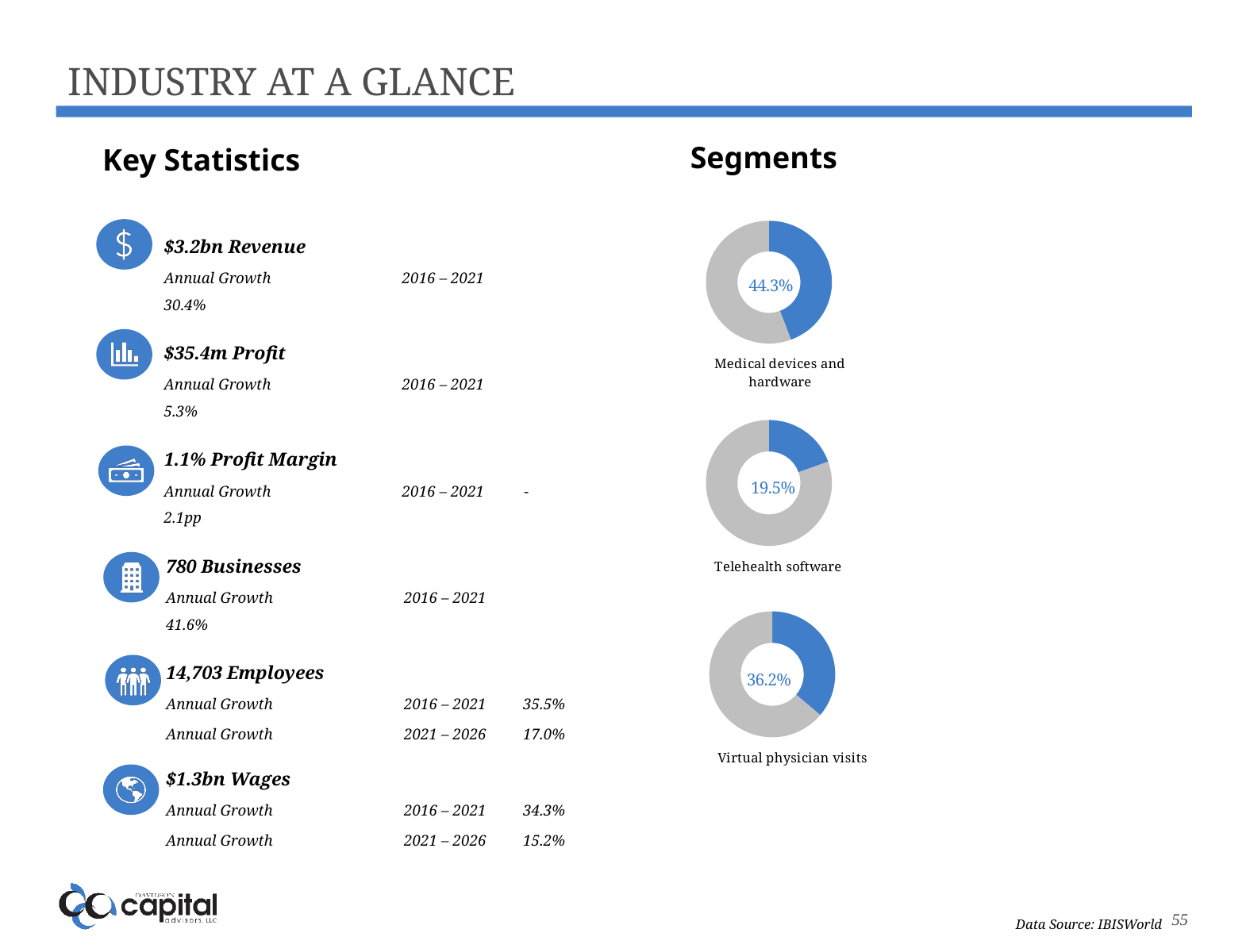
What kind of chart is used to show each segment's share under "Segments"? Donut (pie) chart What percentage is shown in the donut chart labelled "Medical devices and hardware"? 44.3% What is the difference between the percentage in the "Virtual physician visits" donut chart and the percentage in the "Telehealth software" donut chart? 16.7% In the "Telehealth software" donut chart, is the blue slice greater or less than 25%? less How many donut charts are shown under the "Segments" heading? 3 What percentage is shown in the donut chart labelled "Telehealth software"? 19.5% Among the three segment donut charts, which segment has the highest percentage? Medical devices and hardware What colour is the highlighted slice in each of the segment donut charts? Blue Among the three segment donut charts, which segment has the lowest percentage? Telehealth software What is the difference between the percentage in the "Medical devices and hardware" donut chart and the percentage in the "Virtual physician visits" donut chart? 8.1% What percentage is shown in the donut chart labelled "Virtual physician visits"? 36.2% Which segment has a larger percentage in its donut chart: Telehealth software or Virtual physician visits? Virtual physician visits